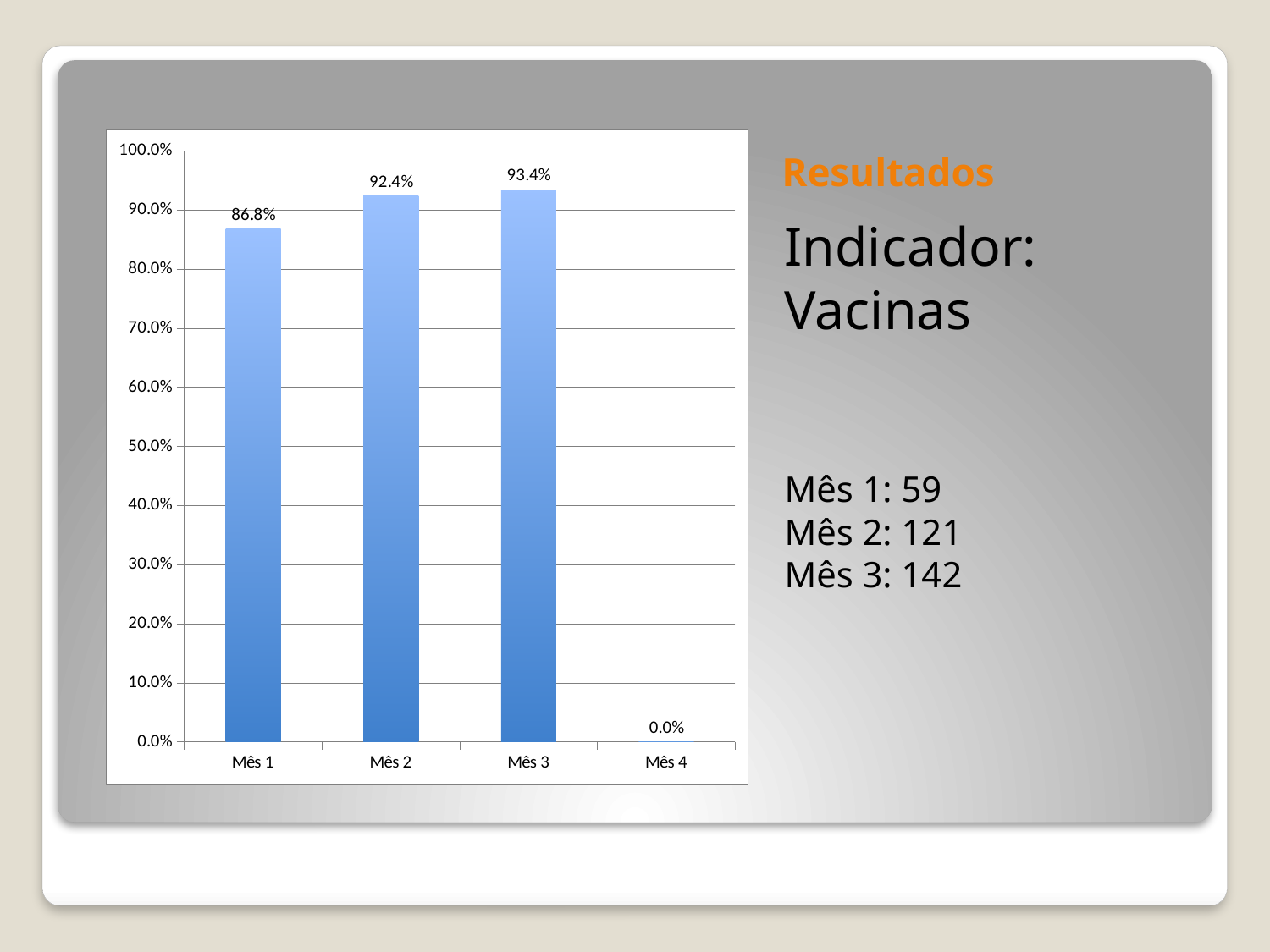
Which category has the lowest value? Mês 4 What is the value for Mês 3? 93.4% What is the difference between the values for Mês 3 and Mês 1? 6.6% What kind of chart is shown on the slide? Bar chart Which category has the highest value? Mês 3 How many categories are shown on the x axis? 4 What is the value for Mês 4? 0.0% What is the value for Mês 1? 86.8% What is the value for Mês 2? 92.4% What is the difference between the values for Mês 2 and Mês 1? 5.6% Is the value for Mês 1 greater or less than 80.0%? greater Which is larger, the value for Mês 1 or the value for Mês 2? Mês 2